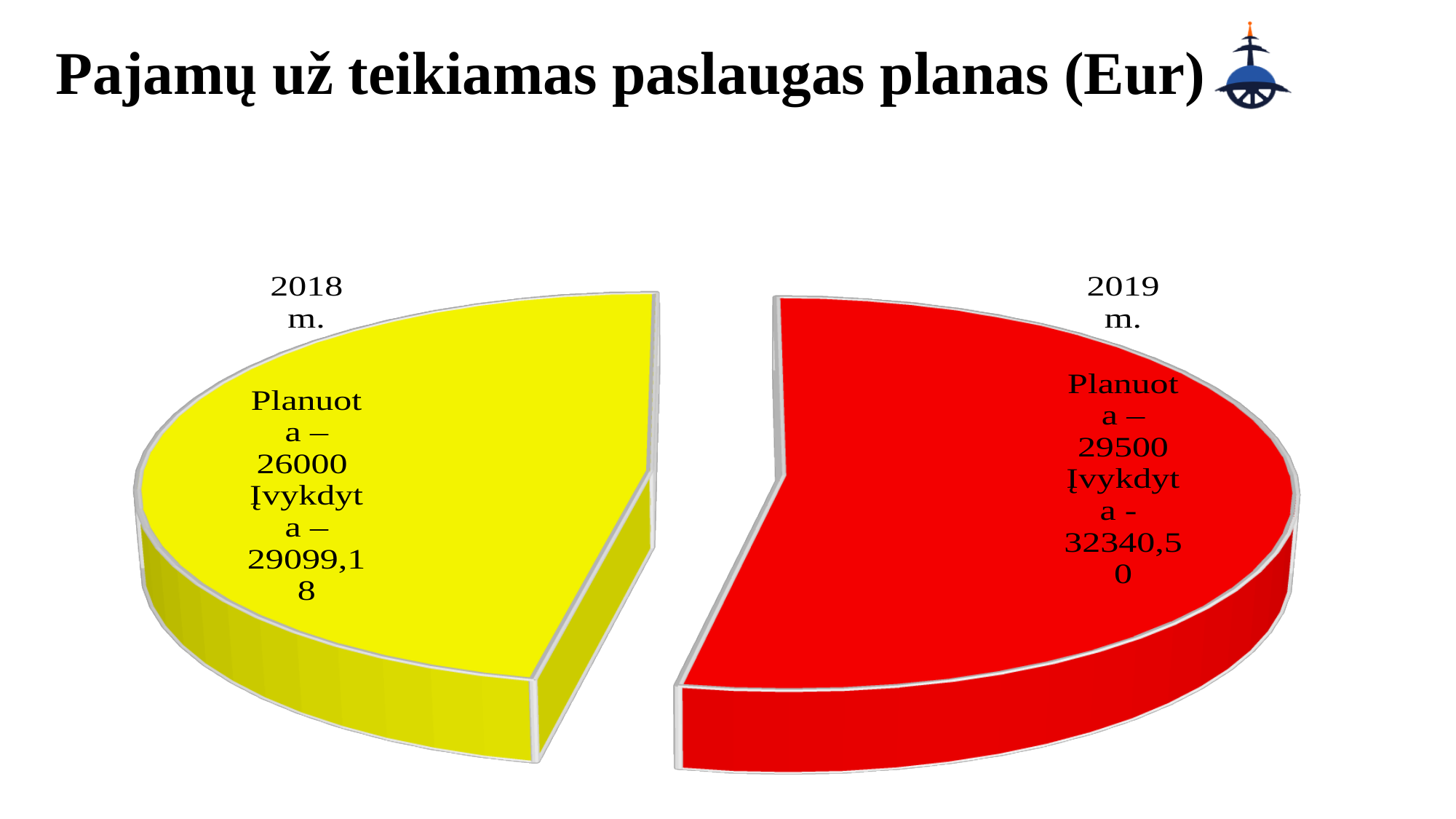
What is the planned (Planuota) value for 2018 m.? 26000 What is the difference between the planned values for 2019 m. and 2018 m.? 3500 Which year has the larger slice in the pie chart? 2019 m. What colour is the slice for 2019 m.? Red What is the difference between the executed and planned values for 2018 m.? 3099,18 Which is larger, the planned value for 2018 m. or the planned value for 2019 m.? 2019 m. What kind of chart is shown on the slide? Pie chart What is the executed (Įvykdyta) value for 2018 m.? 29099,18 How many slices does the pie chart have? 2 What is the executed (Įvykdyta) value for 2019 m.? 32340,50 What is the planned (Planuota) value for 2019 m.? 29500 What is the title of the chart on the slide? Pajamų už teikiamas paslaugas planas (Eur)